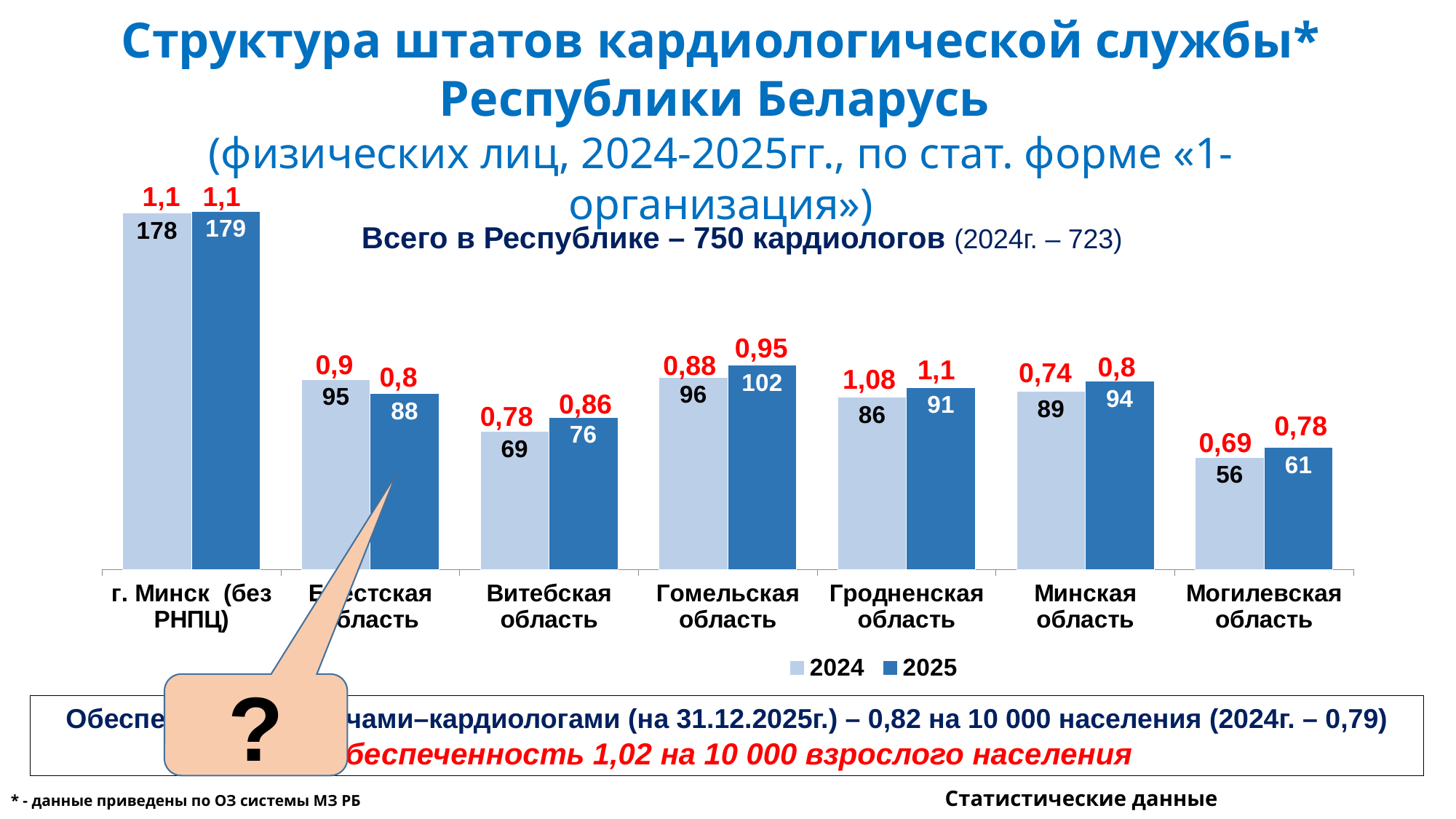
Which category has the lowest 2024 value? Могилевская область What red label is printed above the 2025 bar for Гродненская область? 1,1 What is the difference between the 2025 and 2024 values for Витебская область? 7 What is the 2025 value for Гомельская область? 102 What is the 2024 value for Витебская область? 69 What kind of chart is shown on the slide? bar chart How many series does the legend list? 2 Which category has the highest 2025 value? г. Минск (без РНПЦ) What is the 2025 value for Могилевская область? 61 What is the difference between the 2024 and 2025 values for Брестская область? 7 Which is larger for Минская область: the 2024 value or the 2025 value? 2025 How many categories are shown on the x axis? 7